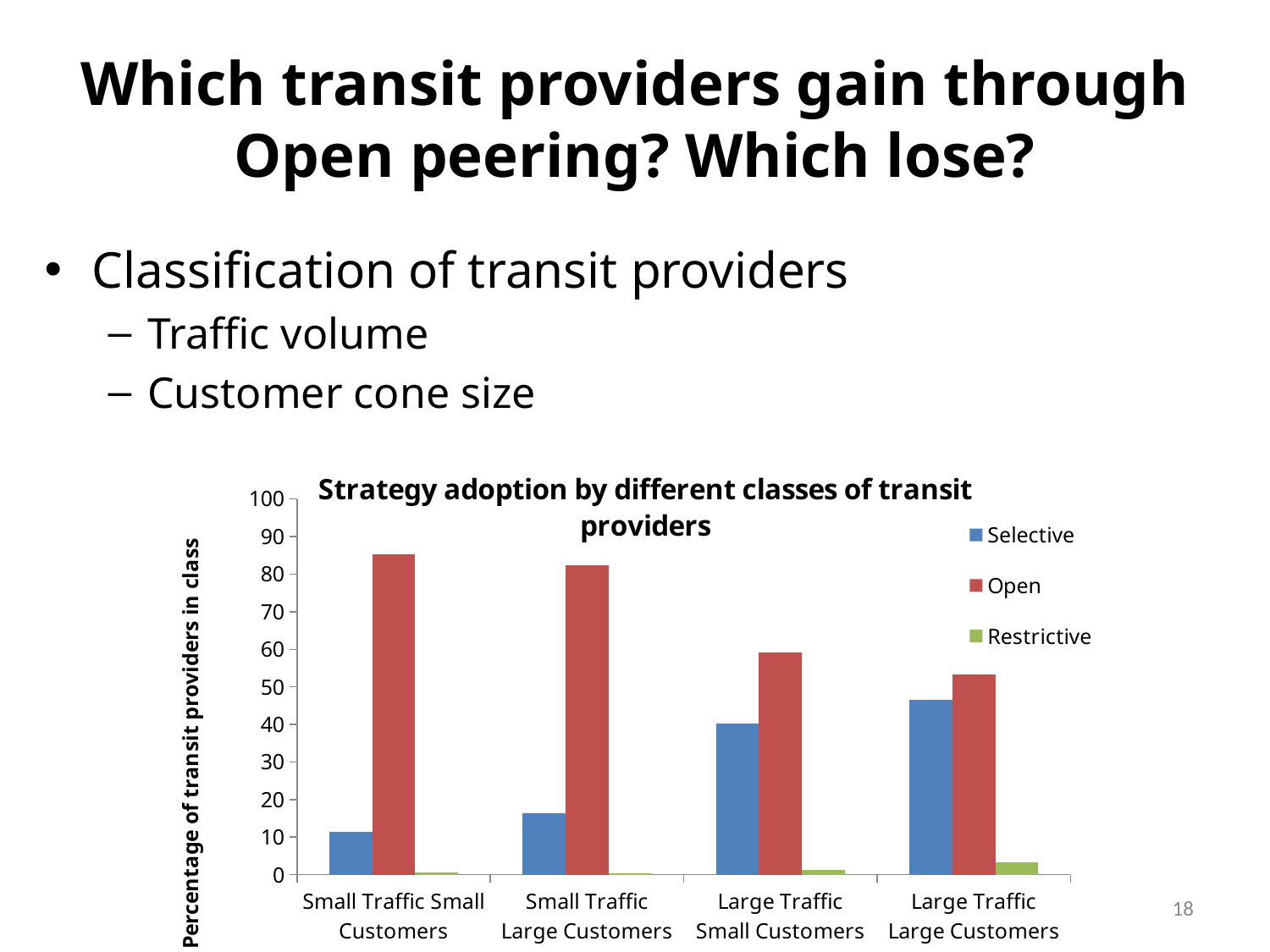
Which class of transit providers has the highest Selective value? Large Traffic Large Customers Do the Selective values rise or fall moving left to right along the x axis? rise Is the Restrictive value for Large Traffic Large Customers greater or less than 10? less Which class of transit providers has the lowest Open value? Large Traffic Large Customers Is the Open value for Small Traffic Small Customers greater or less than 80? greater How many classes of transit providers are shown on the x axis? 4 Which class of transit providers has the lowest Selective value? Small Traffic Small Customers Is the Selective value for Large Traffic Small Customers greater or less than 50? less How many series does the legend list? 3 For Large Traffic Large Customers, which is larger, the Open value or the Selective value? Open What is the title of the chart? Strategy adoption by different classes of transit providers What kind of chart is shown on the slide? bar chart